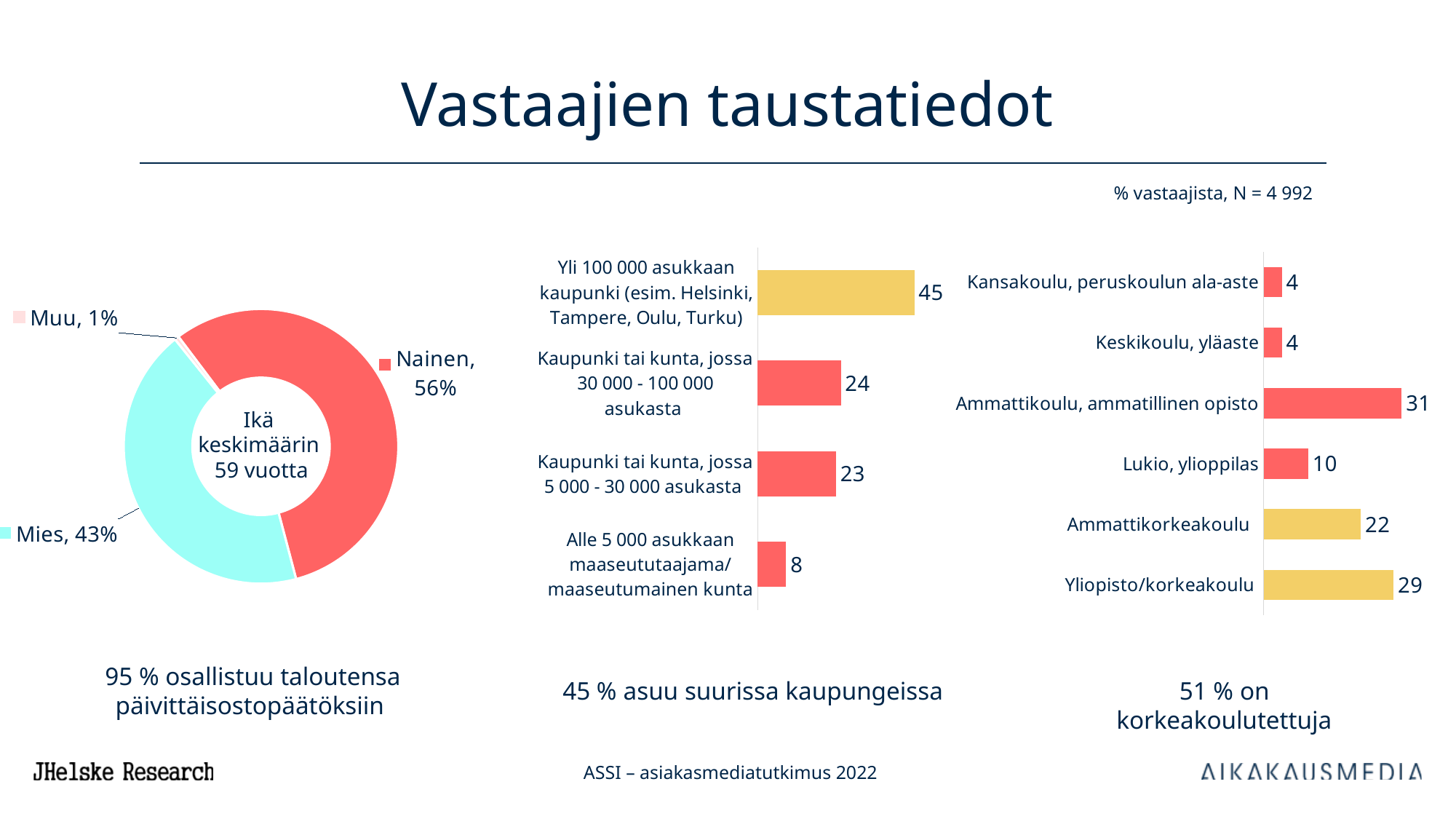
In the middle bar chart, what is the difference between 'Kaupunki tai kunta, jossa 30 000 - 100 000 asukasta' and 'Kaupunki tai kunta, jossa 5 000 - 30 000 asukasta'? 1 In the donut chart on the left, which category has the smallest share? Muu In the right-hand bar chart, which category has the highest value? Ammattikoulu, ammatillinen opisto In the right-hand bar chart, how many categories are shown? 6 In the donut chart on the left, what share of respondents are Mies? 43% In the right-hand bar chart, which is larger: 'Ammattikorkeakoulu' or 'Lukio, ylioppilas'? Ammattikorkeakoulu In the donut chart on the left, what share of respondents are Nainen? 56% In the donut chart on the left, how many categories are shown? 3 In the middle bar chart, which category has the lowest value? Alle 5 000 asukkaan maaseututaajama/maaseutumainen kunta In the middle bar chart, what is the value for 'Yli 100 000 asukkaan kaupunki (esim. Helsinki, Tampere, Oulu, Turku)'? 45 In the donut chart on the left, what text is written in the centre of the donut? Ikä keskimäärin 59 vuotta In the right-hand bar chart, what is the value for 'Yliopisto/korkeakoulu'? 29